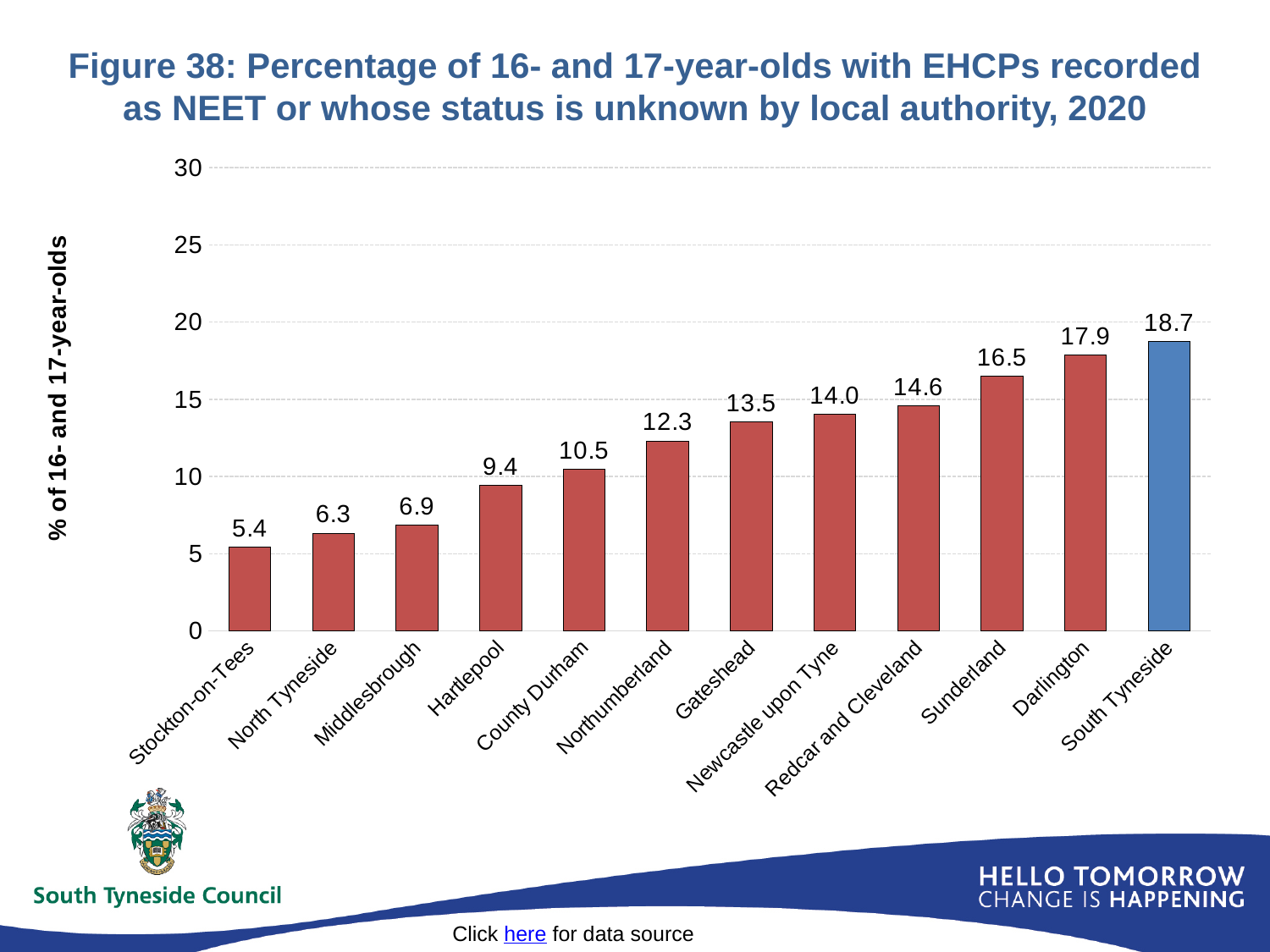
What is the value for Newcastle upon Tyne? 14.0 Which is larger, the value for Darlington or the value for Redcar and Cleveland? Darlington Which local authority has the lowest value? Stockton-on-Tees What is the difference between the values for Sunderland and Gateshead? 3.0 How many local authorities are shown on the chart? 12 What is the difference between the values for South Tyneside and Stockton-on-Tees? 13.3 What kind of chart is shown on the slide? Bar chart Do the values rise or fall from left to right along the x axis? Rise Which local authority has the highest value? South Tyneside Is the value for Northumberland greater or less than 10? greater What is the value for Hartlepool? 9.4 What is the value for South Tyneside? 18.7